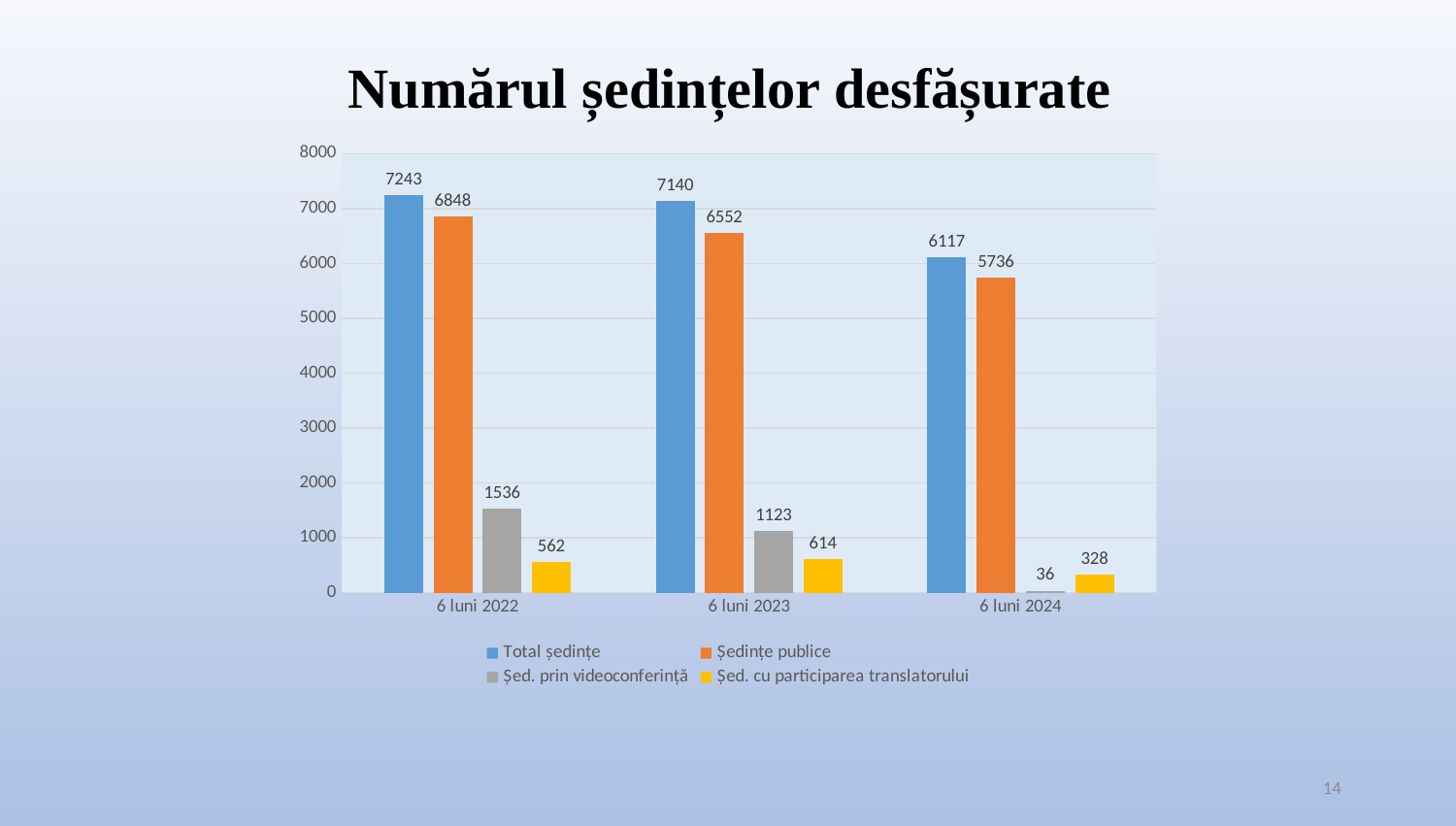
What kind of chart is shown on the slide? Bar chart What is the value of Total ședințe for 6 luni 2022? 7243 What is the value of Ședințe publice for 6 luni 2024? 5736 Does the value of Total ședințe rise or fall from 6 luni 2022 to 6 luni 2024? Fall How many periods are shown on the x axis? 3 How many series does the legend list? 4 What is the value of Șed. prin videoconferință for 6 luni 2023? 1123 What is the value of Șed. cu participarea translatorului for 6 luni 2024? 328 Which period has the highest value for Total ședințe? 6 luni 2022 Which period has the lowest value for Șed. prin videoconferință? 6 luni 2024 What is the difference between Total ședințe and Ședințe publice for 6 luni 2023? 588 Which is larger: Șed. cu participarea translatorului for 6 luni 2022 or for 6 luni 2023? 6 luni 2023